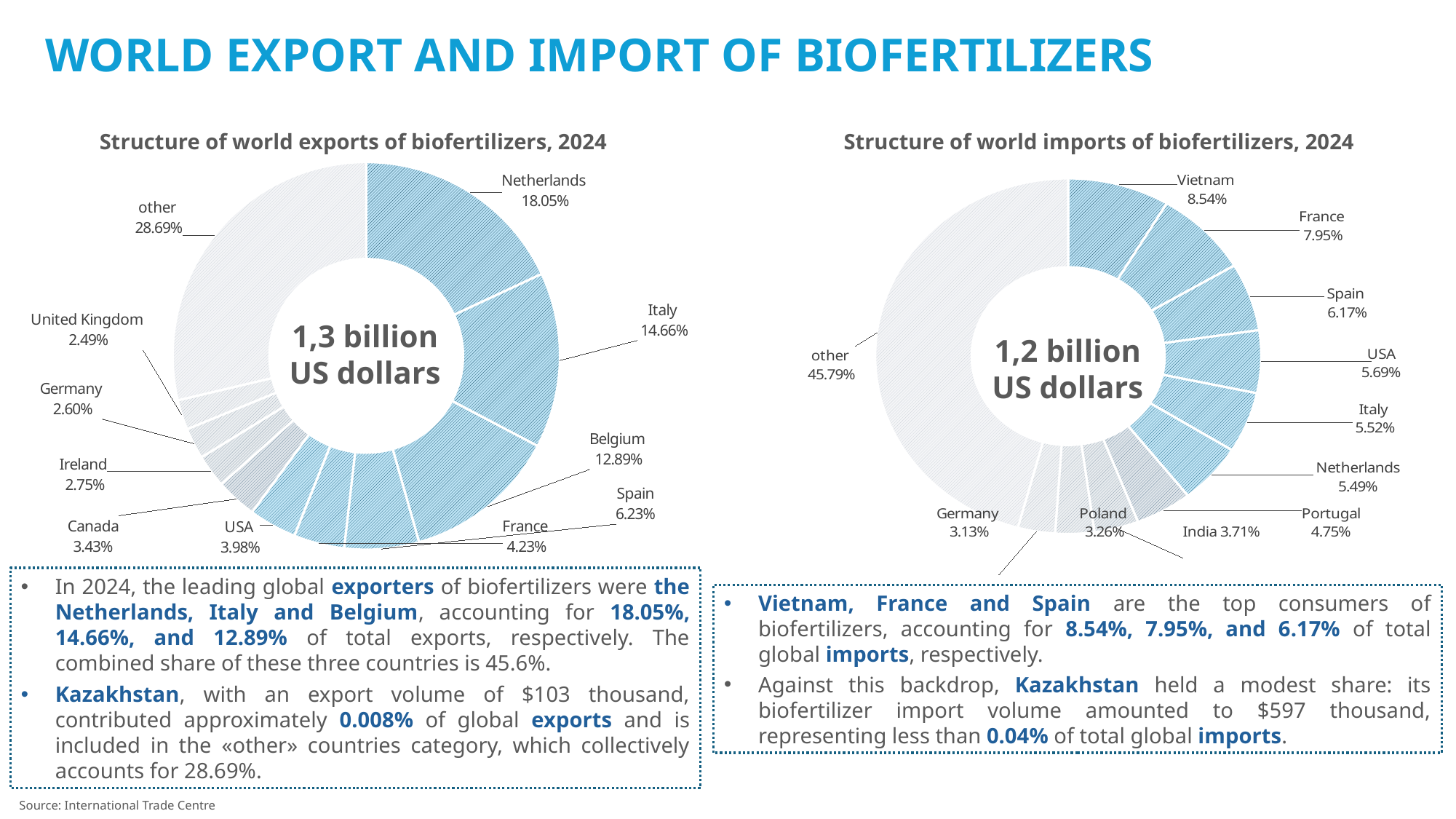
In the 'Structure of world imports of biofertilizers, 2024' chart, what share does Vietnam hold? 8.54% What total value is shown in the centre of the 'Structure of world imports of biofertilizers, 2024' chart? 1,2 billion US dollars In the 'Structure of world imports of biofertilizers, 2024' chart, what share is labelled 'other'? 45.79% In the 'Structure of world imports of biofertilizers, 2024' chart, which named country has the largest share? Vietnam In the 'Structure of world exports of biofertilizers, 2024' chart, what share does Canada hold? 3.43% What kind of chart is the 'Structure of world imports of biofertilizers, 2024' chart? Pie (donut) chart In the 'Structure of world exports of biofertilizers, 2024' chart, what share does the Netherlands hold? 18.05% In the 'Structure of world imports of biofertilizers, 2024' chart, which is larger: the share of Spain or the share of Portugal? Spain In the 'Structure of world imports of biofertilizers, 2024' chart, what is the difference between the shares of France and Germany? 4.82% How many slices does the 'Structure of world exports of biofertilizers, 2024' chart have? 11 In the 'Structure of world exports of biofertilizers, 2024' chart, what is the difference between the shares of Italy and Belgium? 1.77% In the 'Structure of world exports of biofertilizers, 2024' chart, which named country has the smallest share? United Kingdom